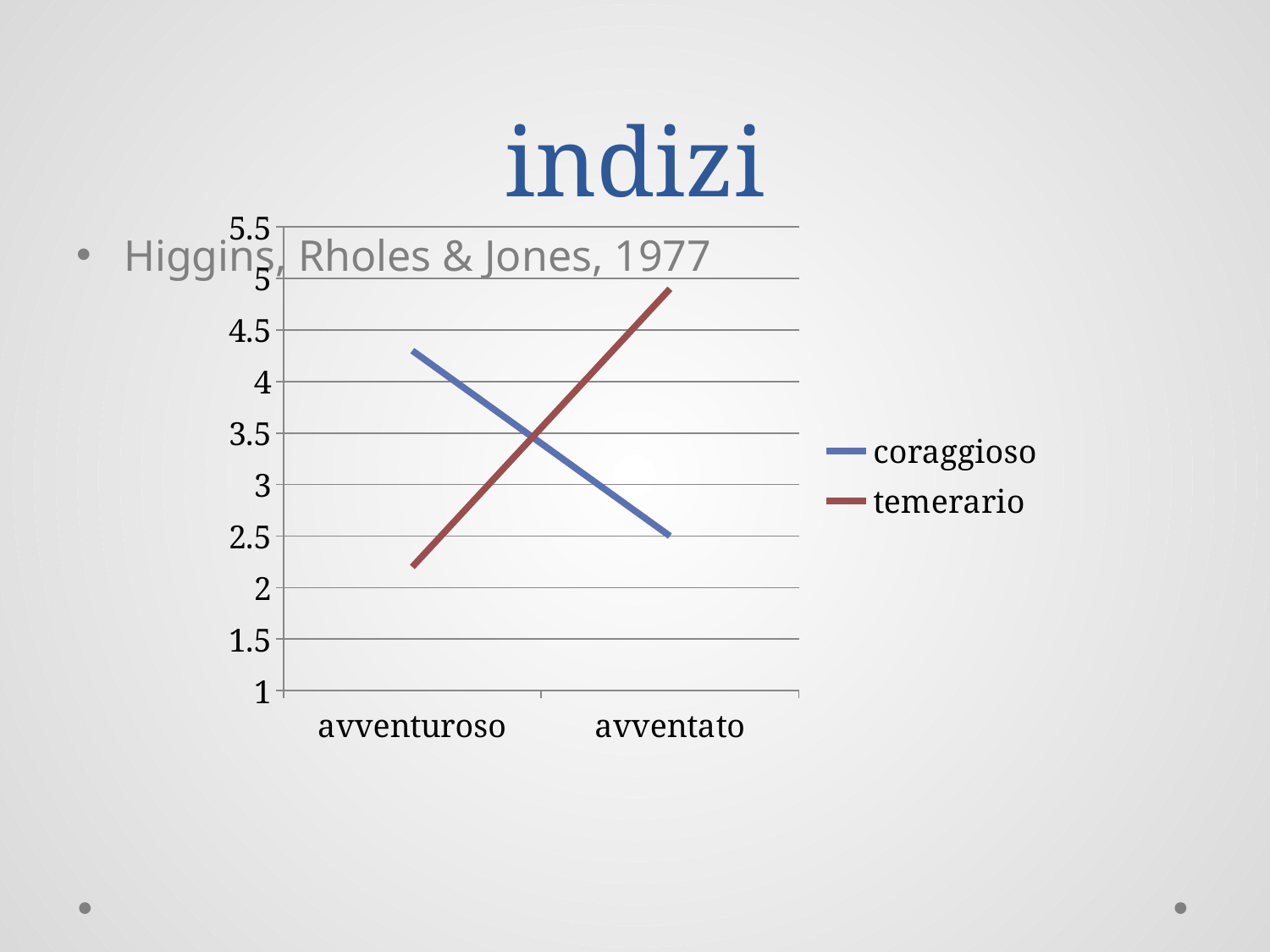
Is the value for temerario at avventuroso greater or less than 3? less What kind of chart is shown on the slide? line chart How many series does the chart legend list? 2 Which series is drawn in blue in the chart? coraggioso How many categories are shown on the x axis of the chart? 2 At avventato, which series has the higher value, coraggioso or temerario? temerario Is the value for coraggioso at avventuroso greater or less than 4? greater Does the coraggioso line rise or fall from avventuroso to avventato? fall At avventuroso, which series has the higher value, coraggioso or temerario? coraggioso Which series is drawn in red in the chart? temerario Does the temerario line rise or fall from avventuroso to avventato? rise Is the value for temerario at avventato greater or less than 4.5? greater